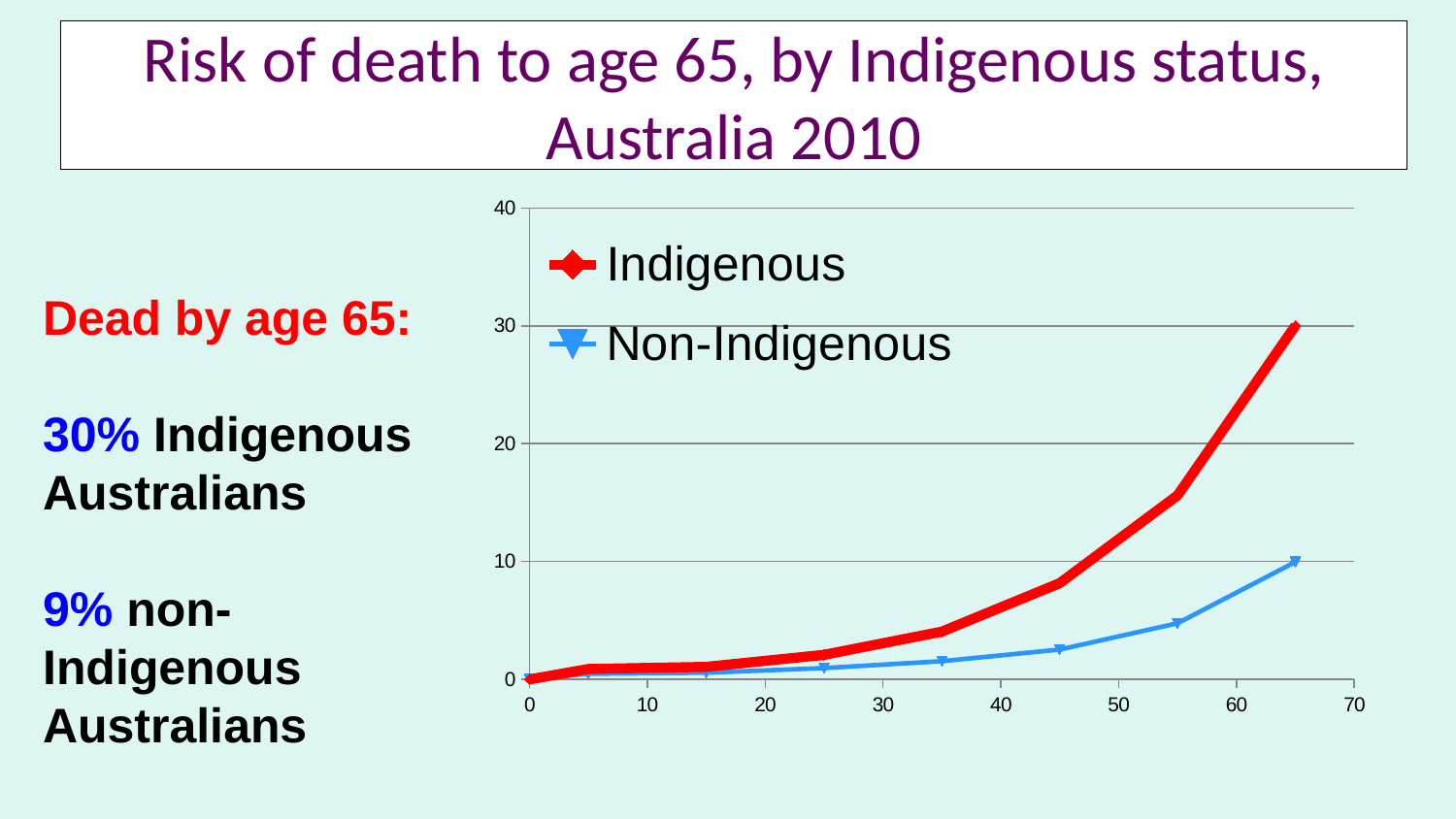
What is the highest value shown on the chart's y axis? 40 At age 65, which series has the higher value, Indigenous or Non-Indigenous? Indigenous Is the value for the Indigenous series at age 55 greater or less than 10? greater What are the two series named in the chart's legend? Indigenous and Non-Indigenous Is the value for the Non-Indigenous series at age 55 greater or less than 10? less Does the Indigenous line rise or fall as age increases along the x axis? rise Is the value for the Non-Indigenous series at age 65 greater or less than 20? less Which series reaches the highest value on the chart? Indigenous How many series does the chart's legend list? 2 What kind of chart is shown on the slide? line chart What is the value of the Indigenous series at age 65? 30